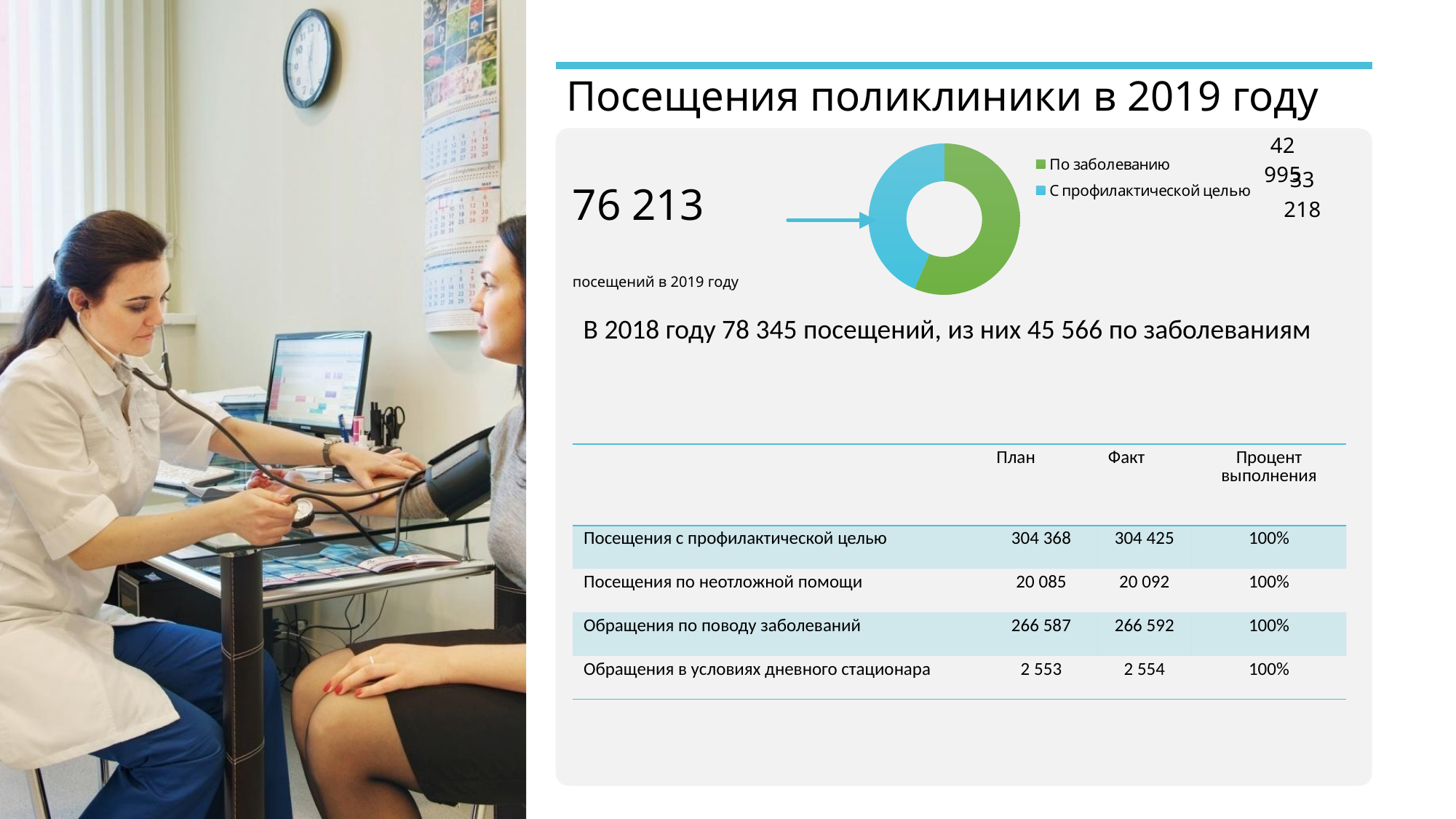
How many entries does the legend of the donut chart list? 2 What total number of visits in 2019 is shown next to the donut chart? 76 213 Which is larger in the donut chart: По заболеванию or С профилактической целью? По заболеванию What colour represents С профилактической целью in the donut chart? blue What colour represents По заболеванию in the donut chart? green Which category has the smaller share of the donut chart? С профилактической целью What kind of chart is shown on the slide? pie chart (donut) Which category has the larger share of the donut chart? По заболеванию How many categories does the donut chart show? 2